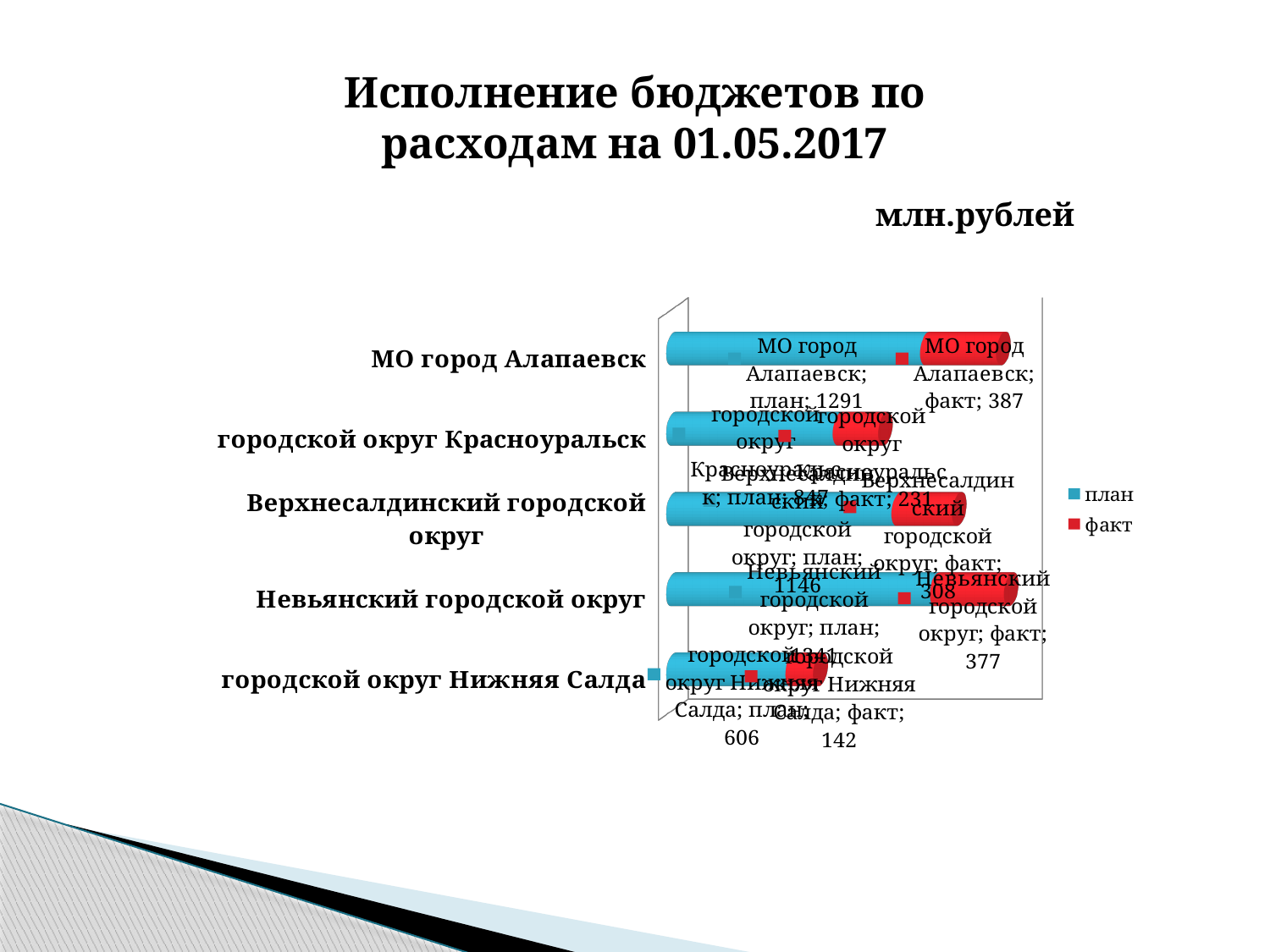
What is the difference between the план and факт values for городской округ Нижняя Салда? 464 Which is larger: the факт value for МО город Алапаевск or the факт value for Невьянский городской округ? МО город Алапаевск How many series does the chart legend list? 2 What is the план value for МО город Алапаевск? 1291 Which municipality has the highest план value? Невьянский городской округ What is the факт value for городской округ Нижняя Салда? 142 How many municipalities (categories) are shown in the chart? 5 Which municipality has the lowest факт value? городской округ Нижняя Салда What is the план value for Невьянский городской округ? 1341 What is the план value for Верхнесалдинский городской округ? 1146 What is the факт value for МО город Алапаевск? 387 What type of chart is shown on the slide? bar chart